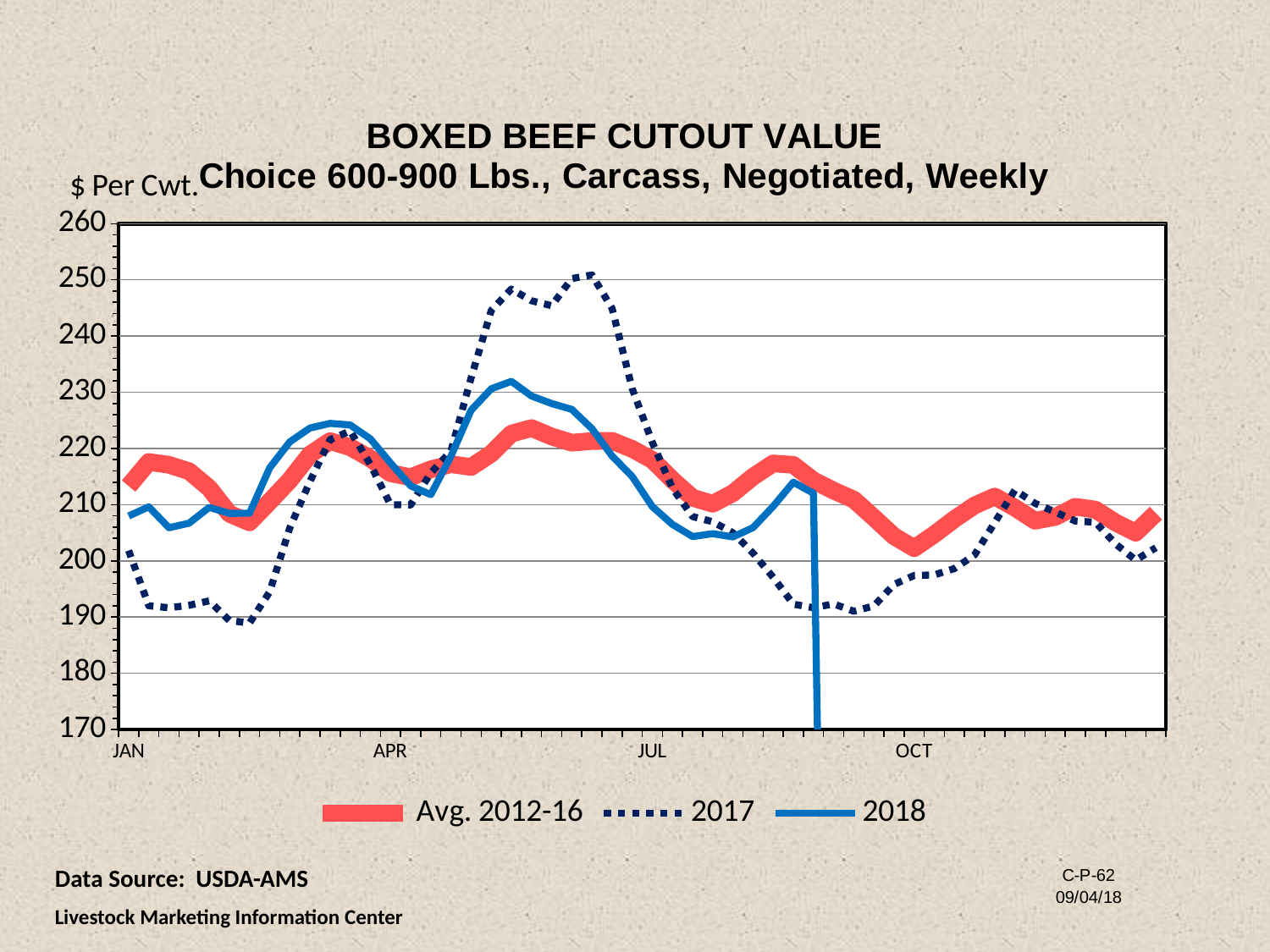
How many series does the legend list? 3 What is the title of the chart? BOXED BEEF CUTOUT VALUE Is the value of the 2017 series in February greater or less than 200? less What kind of chart is shown on the slide? line chart Which series reaches the lowest value on the chart (ignoring the vertical drop at the end of the 2018 line)? 2017 Does the 2017 series rise or fall from JAN to its June peak? rise Is the peak value of the 2017 series greater or less than 240? greater Is the peak value of the 2018 series greater or less than 220? greater Around the June peak, which series is higher, 2017 or 2018? 2017 Which series reaches the highest value on the chart? 2017 What unit is shown on the vertical axis label? $ Per Cwt. At OCT, which series is higher, Avg. 2012-16 or 2017? Avg. 2012-16